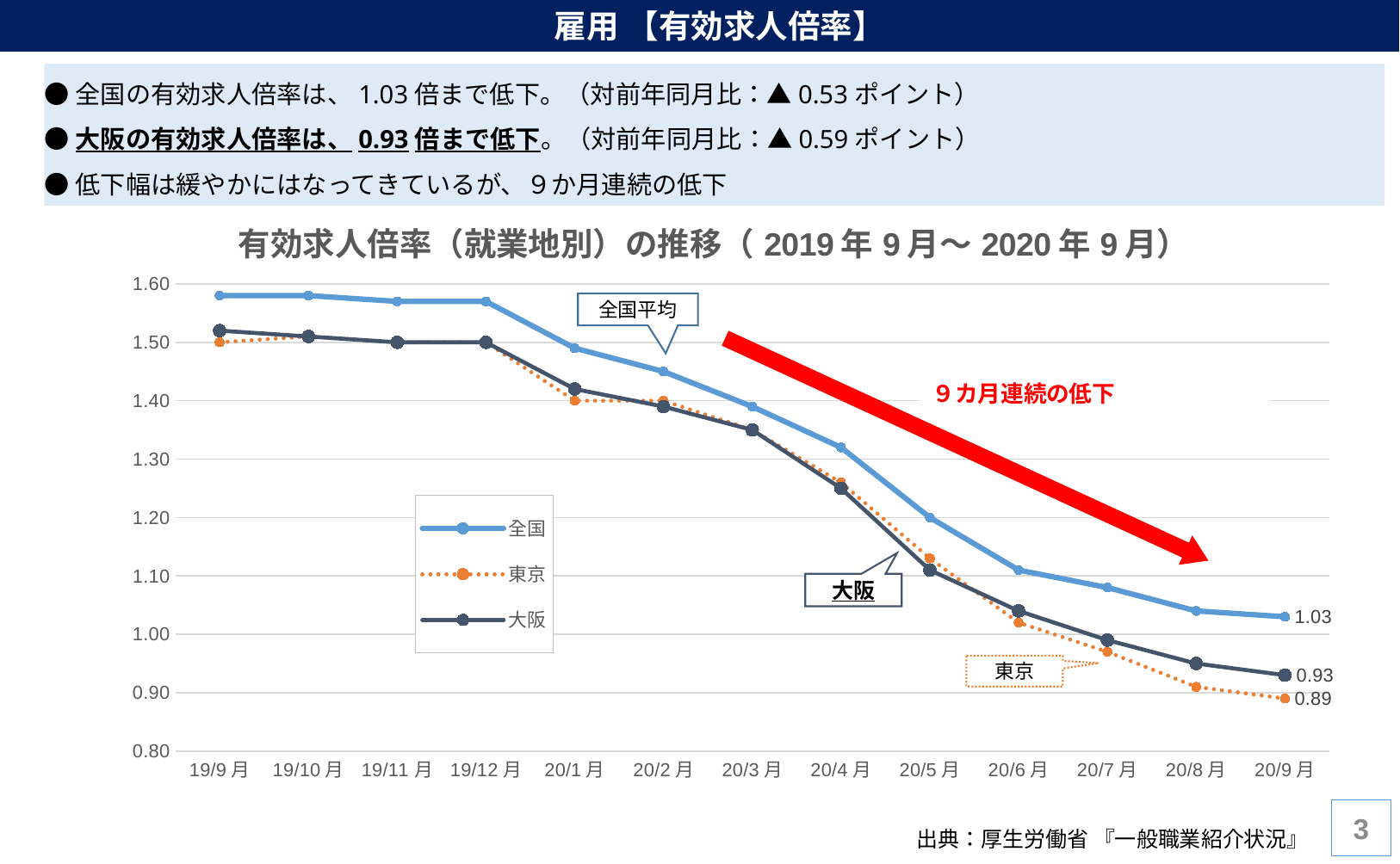
Which series has the lowest value at 20/9月? 東京 What is the value of the 東京 series at 20/9月? 0.89 Do the values of the 全国 series rise or fall from 19/9月 to 20/9月? fall Is the value for 全国 at 19/9月 greater or less than 1.50? greater Which series has the highest value at 20/9月? 全国 Is the value for 大阪 at 20/5月 greater or less than 1.20? less How many months are plotted along the x axis? 13 How many series does the legend list? 3 What is the value of the 大阪 series at 20/9月? 0.93 What is the difference between the 全国 and 大阪 values at 20/9月? 0.10 What is the value of the 全国 series at 20/9月? 1.03 What is the difference between the 大阪 and 東京 values at 20/9月? 0.04